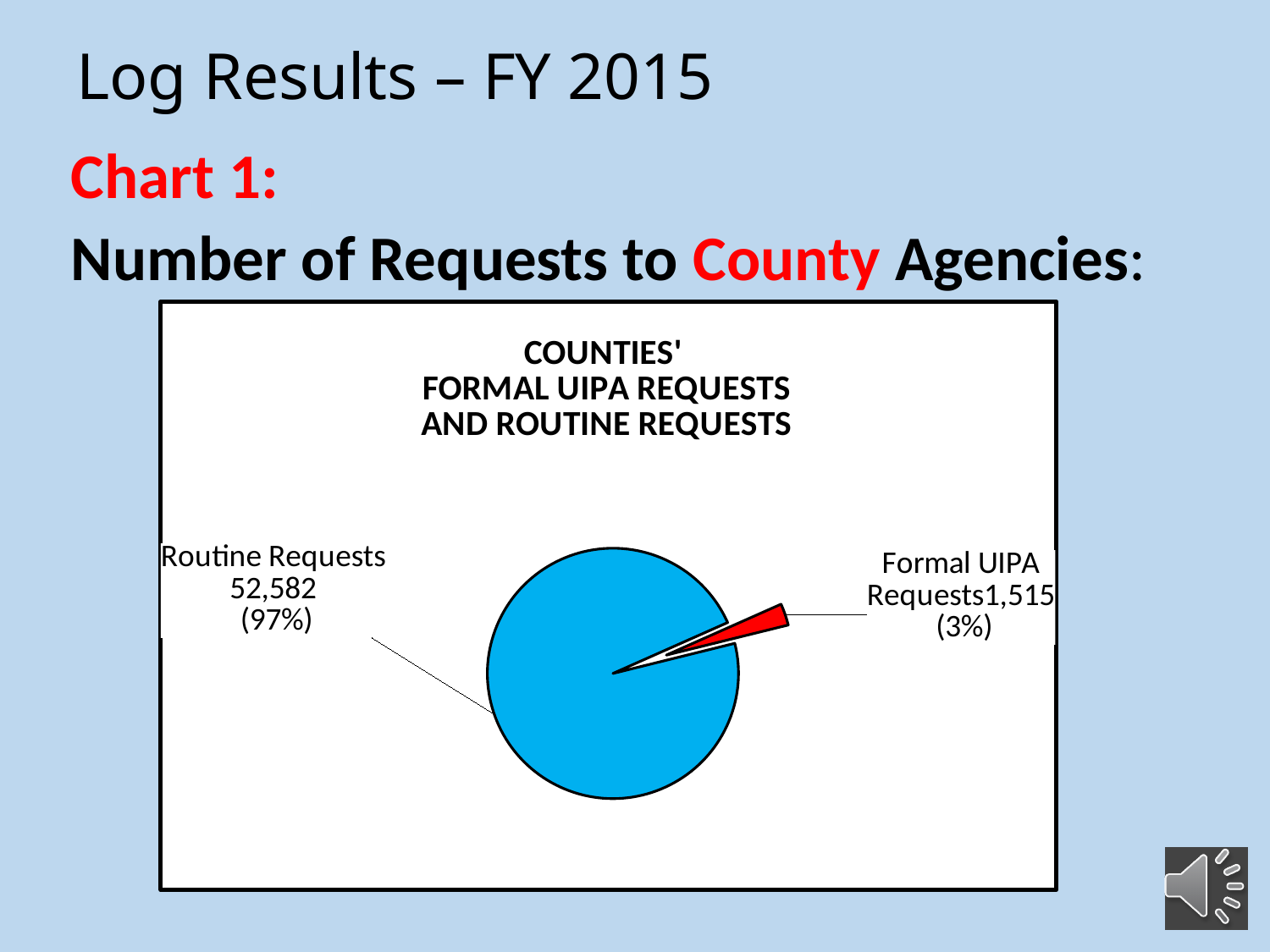
What share of the pie do Routine Requests make up? 97% Which category has the smallest slice of the pie? Formal UIPA Requests How many Formal UIPA Requests are shown in the pie chart? 1,515 What kind of chart is shown on the slide? pie chart What is the difference between the number of Routine Requests and Formal UIPA Requests? 51,067 How many slices does the pie chart have? 2 Which category has the largest slice of the pie? Routine Requests What is the total number of requests shown in the pie chart? 54,097 What is the title of the pie chart? COUNTIES' FORMAL UIPA REQUESTS AND ROUTINE REQUESTS How many Routine Requests are shown in the pie chart? 52,582 What share of the pie do Formal UIPA Requests make up? 3% Which is larger, Routine Requests or Formal UIPA Requests? Routine Requests